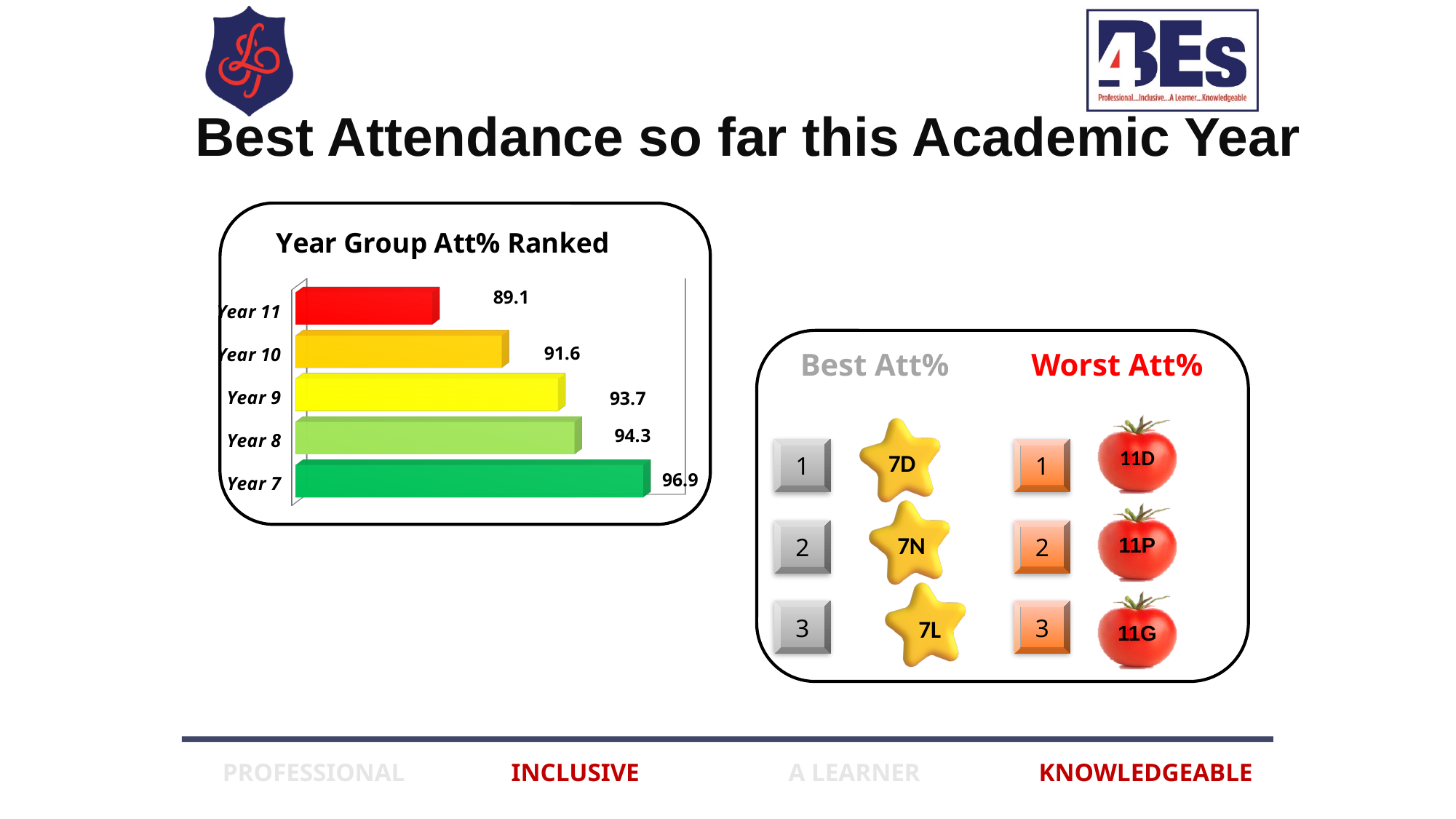
What is the value for Year 7 in the Year Group Att% Ranked chart? 96.9 How many year groups are shown in the Year Group Att% Ranked chart? 5 What kind of chart is the Year Group Att% Ranked chart? Bar chart What is the difference between the Year 8 and Year 9 values in the Year Group Att% Ranked chart? 0.6 What is the value for Year 11 in the Year Group Att% Ranked chart? 89.1 Which has a higher value in the Year Group Att% Ranked chart, Year 10 or Year 8? Year 8 What is the value for Year 10 in the Year Group Att% Ranked chart? 91.6 Which year group has the highest attendance in the Year Group Att% Ranked chart? Year 7 What colour is the Year 7 bar in the Year Group Att% Ranked chart? Green What is the difference between the Year 7 and Year 11 values in the Year Group Att% Ranked chart? 7.8 Which year group has the lowest attendance in the Year Group Att% Ranked chart? Year 11 What is the value for Year 9 in the Year Group Att% Ranked chart? 93.7